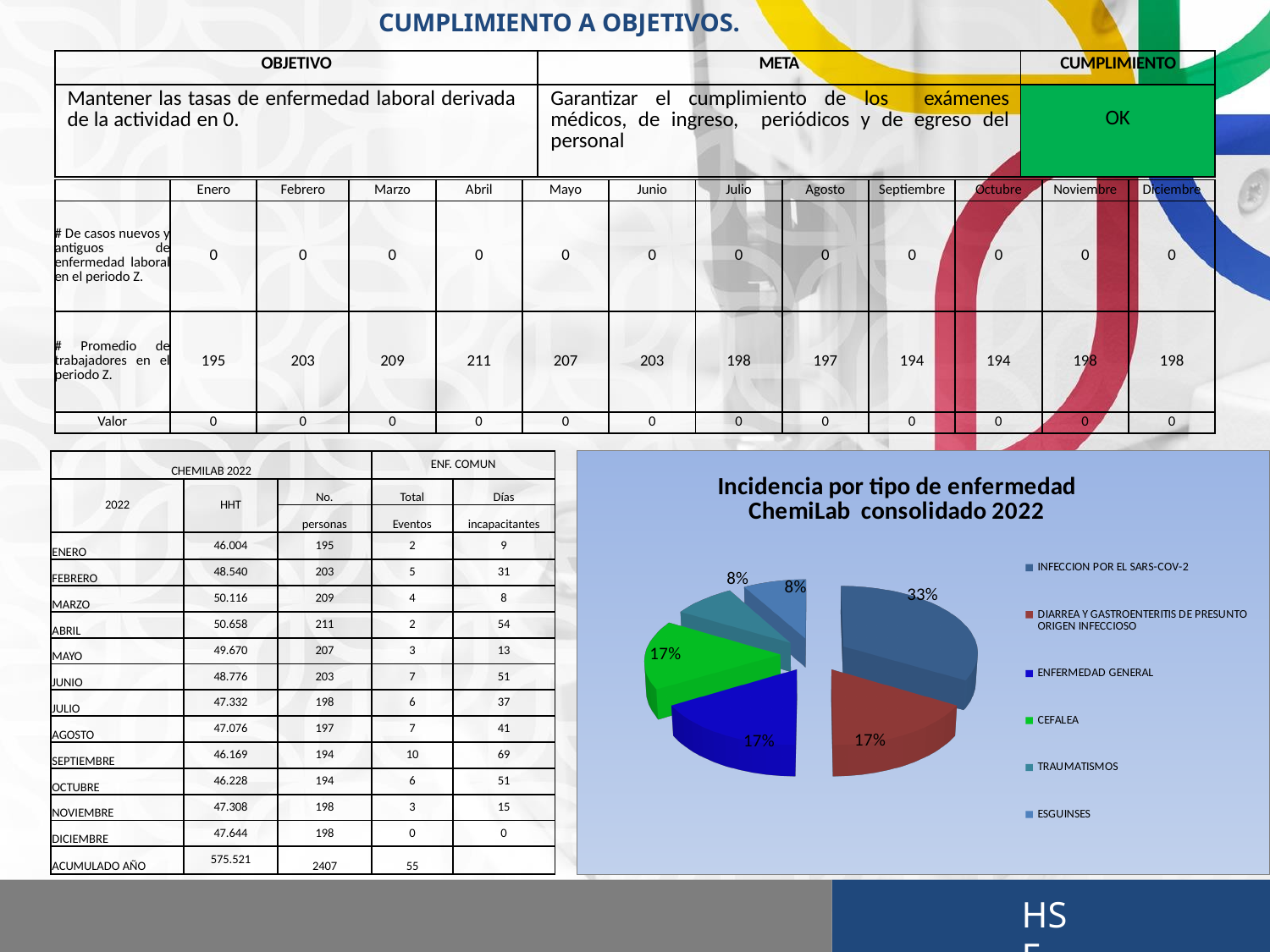
What is the title of the chart? Incidencia por tipo de enfermedad ChemiLab consolidado 2022 What share of the pie does ESGUINSES represent? 8% Which category has the largest slice of the pie chart? INFECCION POR EL SARS-COV-2 What is the percentage shown for ENFERMEDAD GENERAL? 17% Which is larger, the slice for INFECCION POR EL SARS-COV-2 or the slice for DIARREA Y GASTROENTERITIS DE PRESUNTO ORIGEN INFECCIOSO? INFECCION POR EL SARS-COV-2 What share of the pie does TRAUMATISMOS represent? 8% By how many percentage points does the INFECCION POR EL SARS-COV-2 slice exceed the CEFALEA slice? 16 How many categories does the legend of the pie chart list? 6 How many slices of the pie chart are labelled 17%? 3 What share of the pie does INFECCION POR EL SARS-COV-2 represent? 33% What kind of chart is shown on the slide? pie chart